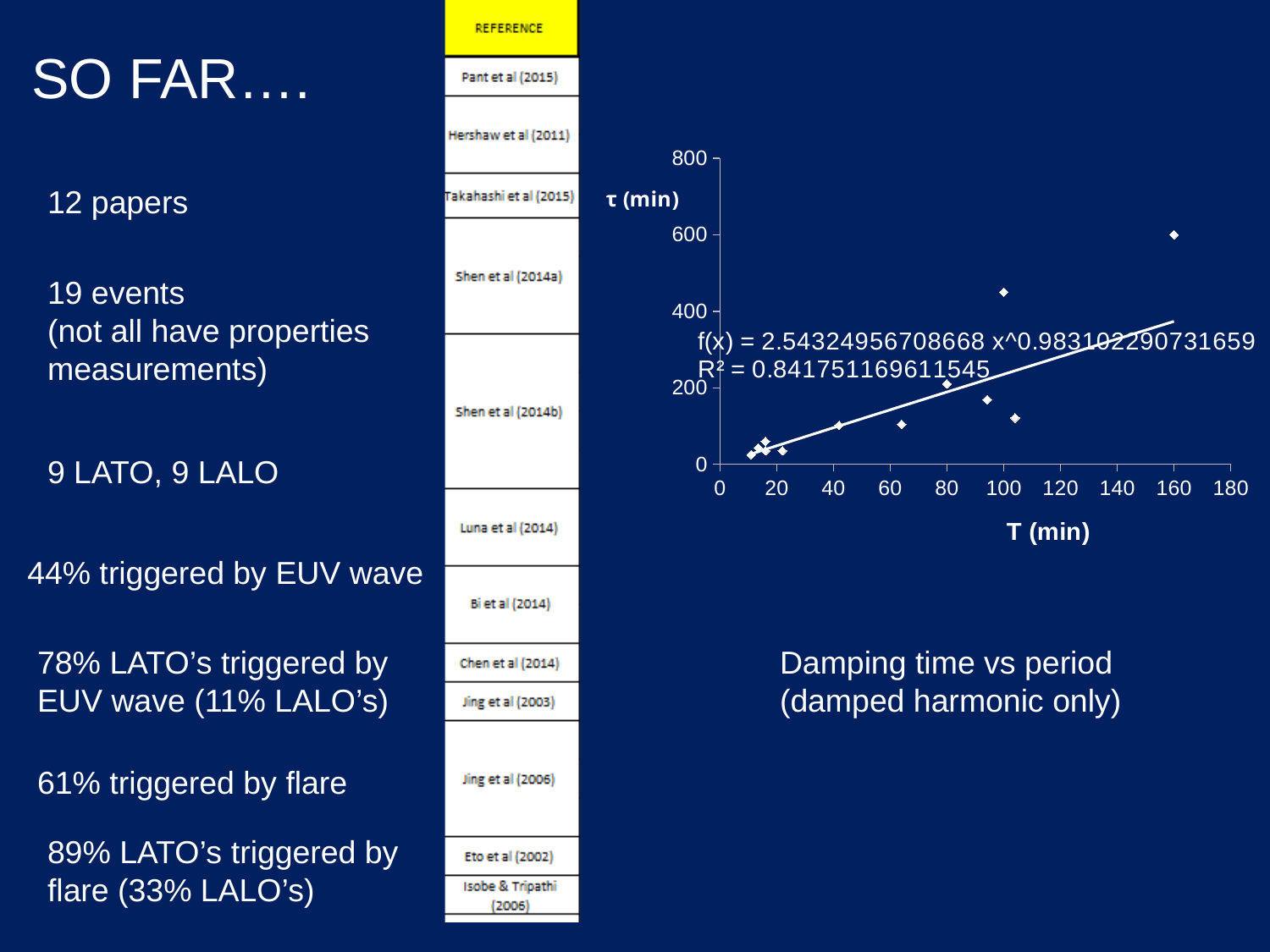
What is the coefficient in front of x in the trendline equation printed on the chart? 2.54324956708668 Is the τ value of the point plotted at about T = 100 min (the higher of the points near T = 100) greater or less than 400? greater Does the damping time τ generally rise or fall as the period T increases along the x axis? rise Is the τ value of the point plotted at about T = 160 min greater or less than 400? greater What kind of chart is shown on the slide? scatter chart What is the exponent of x in the trendline equation printed on the chart? 0.983102290731659 Which point has the highest τ value: the one near T = 160 min or the one near T = 80 min? the one near T = 160 min What R² value is printed on the chart for the fitted trendline? 0.841751169611545 What is the label of the y axis of the chart? τ (min) Is the τ value of the point plotted at about T = 64 min greater or less than 200? less What is the label of the x axis of the chart? T (min) What is the highest value shown on the y axis of the chart? 800